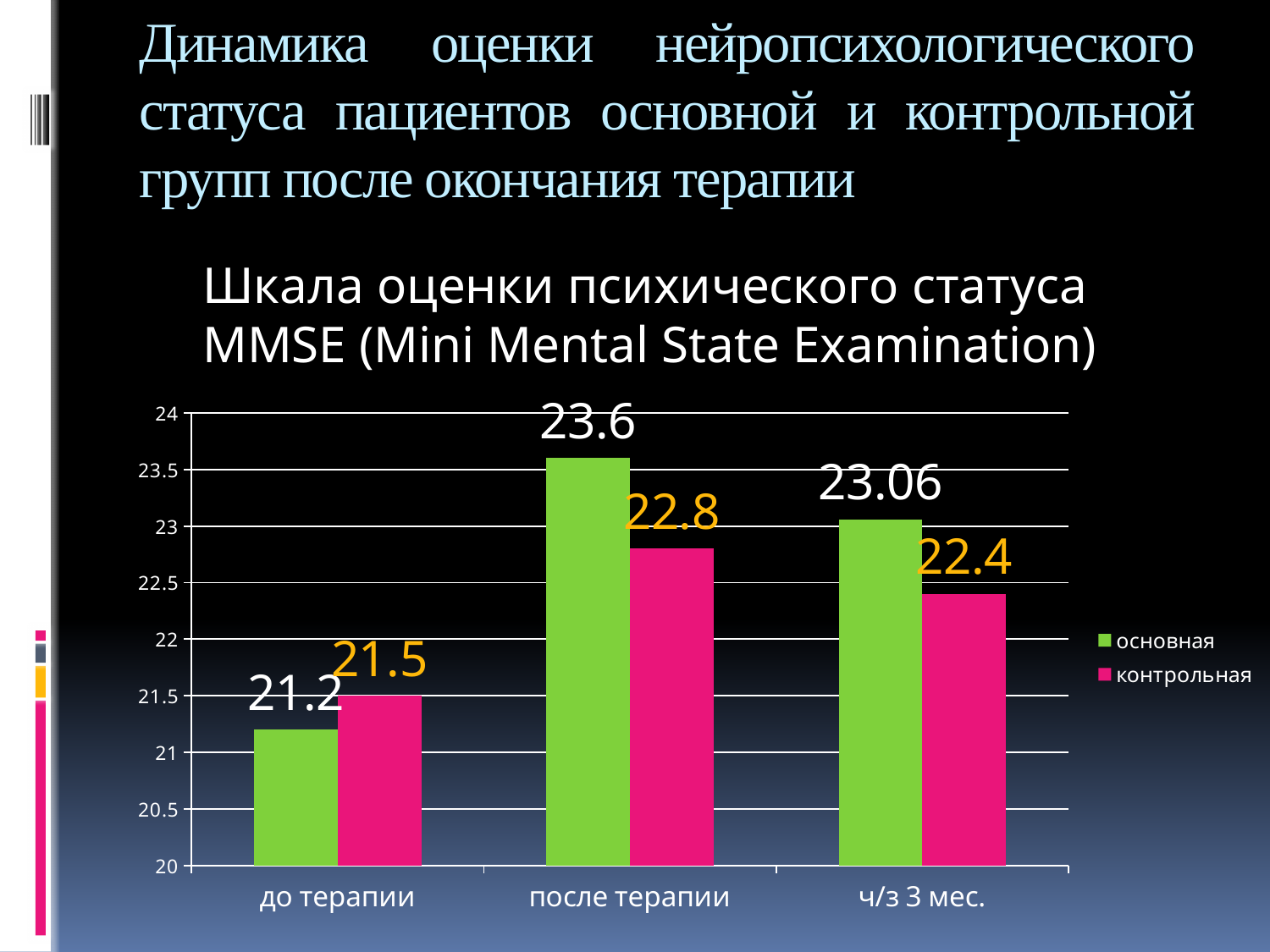
How many categories are shown on the x axis? 3 What is the value for the контрольная series at после терапии? 22.8 At which category does the основная series reach its highest value? после терапии How many series does the legend list? 2 At which category is the контрольная series lowest? до терапии What is the value for the контрольная series at до терапии? 21.5 What is the value for the основная series at ч/з 3 мес.? 23.06 What kind of chart is shown on the slide? bar chart Which series has the larger value at ч/з 3 мес., основная or контрольная? основная What is the difference between the основная and контрольная values at после терапии? 0.8 Is the value for контрольная at ч/з 3 мес. greater or less than 23? less What is the value for the основная series at до терапии? 21.2